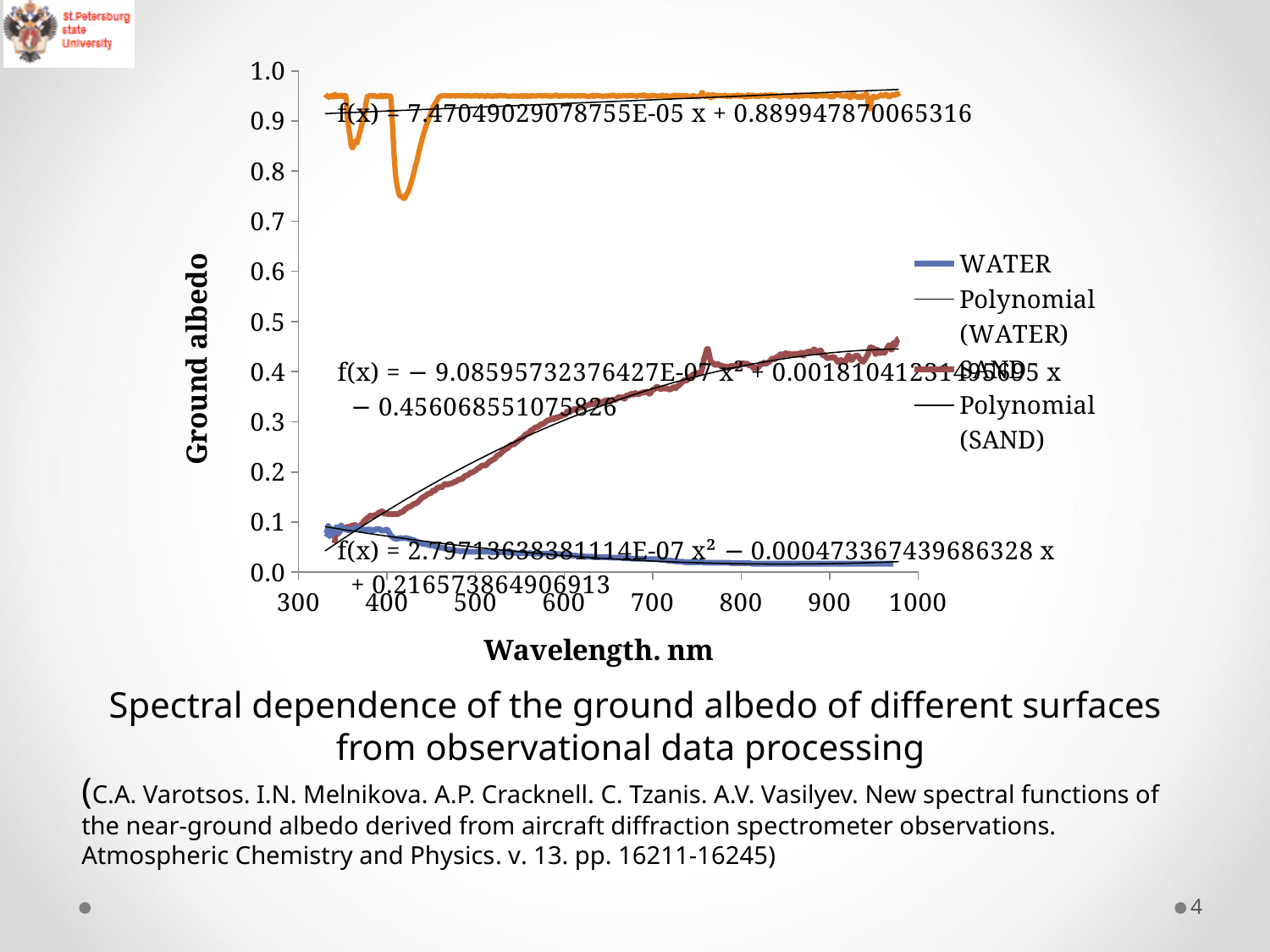
Is the value for SAND at 700 nm greater or less than 0.3? greater Is the value for SAND at 400 nm greater or less than 0.2? less Is the value for SAND at 900 nm greater or less than 0.4? greater What is the label of the y axis of the chart? Ground albedo Does the ground albedo of SAND rise or fall as wavelength increases? rise How many entries does the chart legend list? 4 Of WATER and SAND, which series has the lower ground albedo at 600 nm? WATER At 800 nm, which has the larger ground albedo, WATER or SAND? SAND What kind of chart is shown on the slide? line chart Does the ground albedo of WATER rise or fall as wavelength increases? fall What is the label of the x axis of the chart? Wavelength. nm